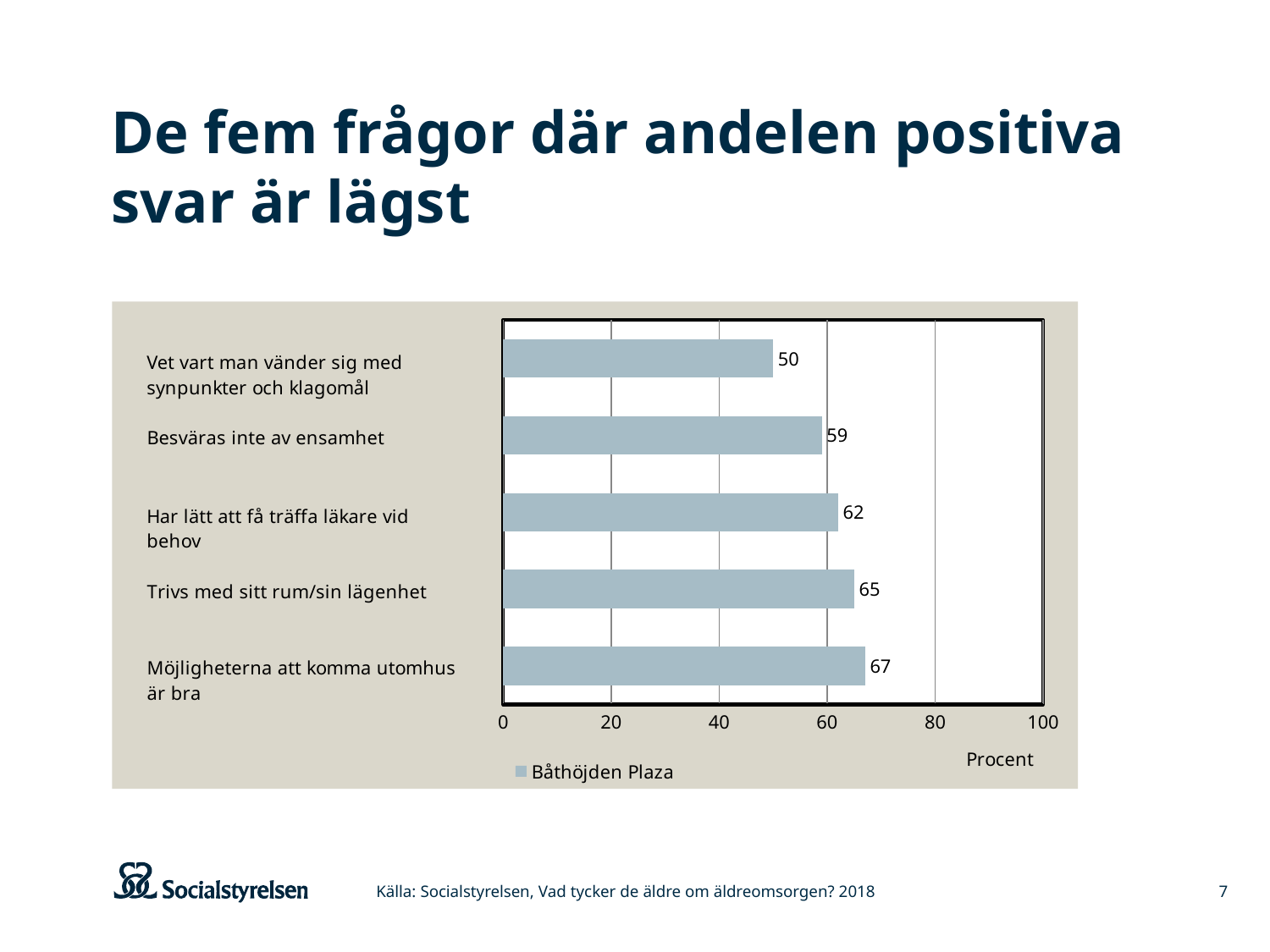
Which category has the lowest value? Vet vart man vänder sig med synpunkter och klagomål Which is larger, the value for "Besväras inte av ensamhet" or the value for "Trivs med sitt rum/sin lägenhet"? Trivs med sitt rum/sin lägenhet Which category has the highest value? Möjligheterna att komma utomhus är bra What kind of chart is shown on the slide? bar chart What series name does the legend show? Båthöjden Plaza How many categories are shown in the chart? 5 What is the difference between the values for "Trivs med sitt rum/sin lägenhet" and "Vet vart man vänder sig med synpunkter och klagomål"? 15 What is the value for "Vet vart man vänder sig med synpunkter och klagomål"? 50 Is the value for "Har lätt att få träffa läkare vid behov" greater or less than 80? less What is the value for "Möjligheterna att komma utomhus är bra"? 67 What is the value for "Besväras inte av ensamhet"? 59 What is the value for "Har lätt att få träffa läkare vid behov"? 62